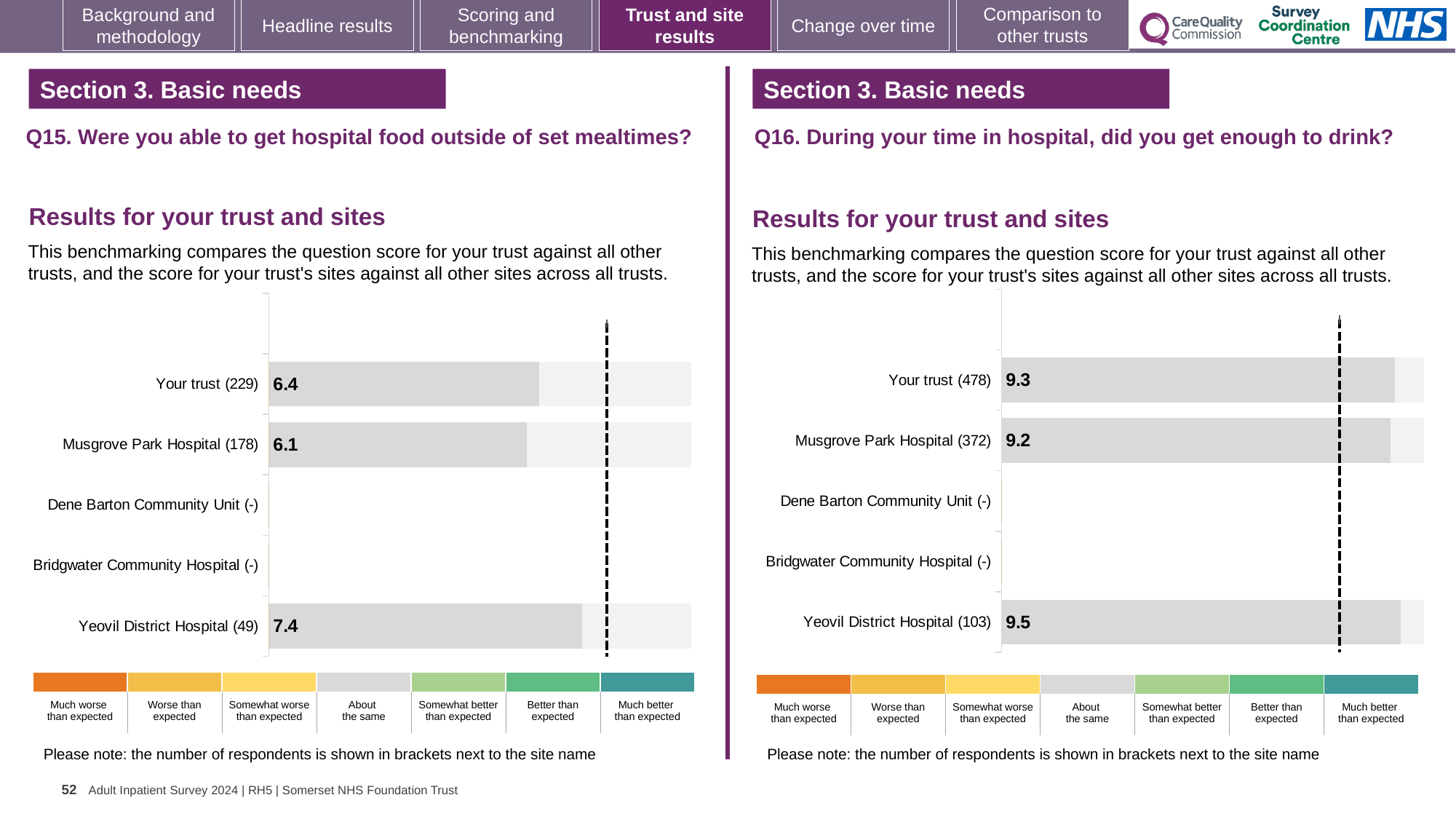
On the Q16 chart (right), what is the score for Your trust (478)? 9.3 On the Q15 chart (left), what is the score for Musgrove Park Hospital (178)? 6.1 On the Q15 chart (left), how many rows (sites including Your trust) are listed on the vertical axis? 5 On the Q15 chart (left), which site has the highest score? Yeovil District Hospital (49) On the Q16 chart (right), what is the score for Yeovil District Hospital (103)? 9.5 On the Q16 chart (right), what is the difference between the scores for Your trust and Musgrove Park Hospital? 0.1 On the Q15 chart (left), what is the score for Your trust (229)? 6.4 On the Q16 chart (right), which site has the lowest score among those with a value shown? Musgrove Park Hospital (372) On the Q15 chart (left), what is the score for Yeovil District Hospital (49)? 7.4 On the Q15 chart (left), which two sites have no score shown (marked with a dash)? Dene Barton Community Unit and Bridgwater Community Hospital What type of chart is used on the Q16 chart (right)? Bar chart On the Q15 chart (left), what is the difference between the scores for Yeovil District Hospital and Musgrove Park Hospital? 1.3